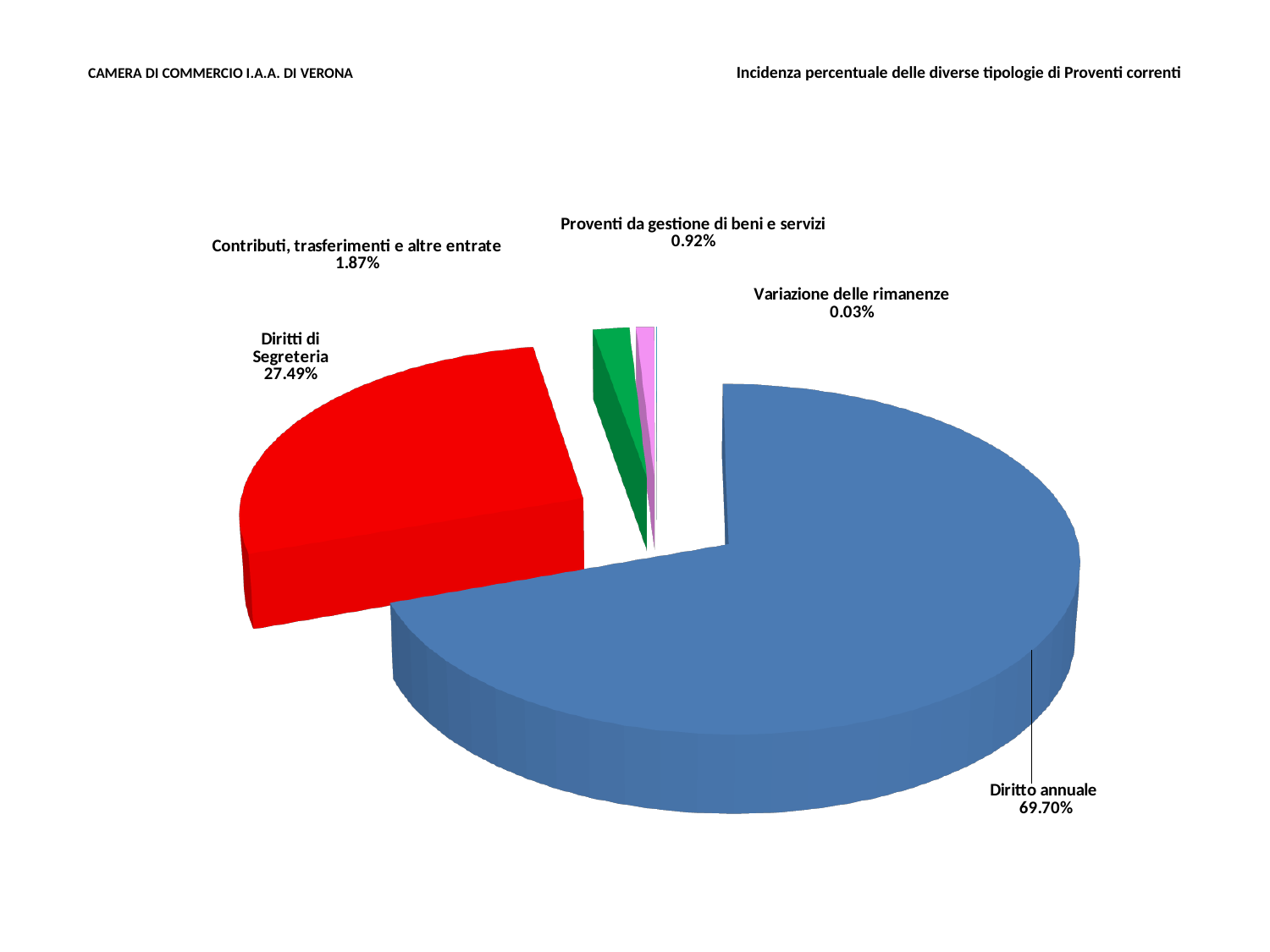
What share of the pie does Diritto annuale represent? 69.70% What percentage is shown for Proventi da gestione di beni e servizi? 0.92% What is the difference in percentage points between Diritto annuale and Diritti di Segreteria? 42.21 What percentage is shown for Diritti di Segreteria? 27.49% What is the title of the chart? Incidenza percentuale delle diverse tipologie di Proventi correnti What is the value labelled for Contributi, trasferimenti e altre entrate? 1.87% Which is larger, the share for Contributi, trasferimenti e altre entrate or the share for Proventi da gestione di beni e servizi? Contributi, trasferimenti e altre entrate How many slices does the pie chart have? 5 Which category has the largest share of the pie? Diritto annuale Which category has the smallest share of the pie? Variazione delle rimanenze What type of chart is shown on the slide? Pie chart What is the value for Variazione delle rimanenze? 0.03%